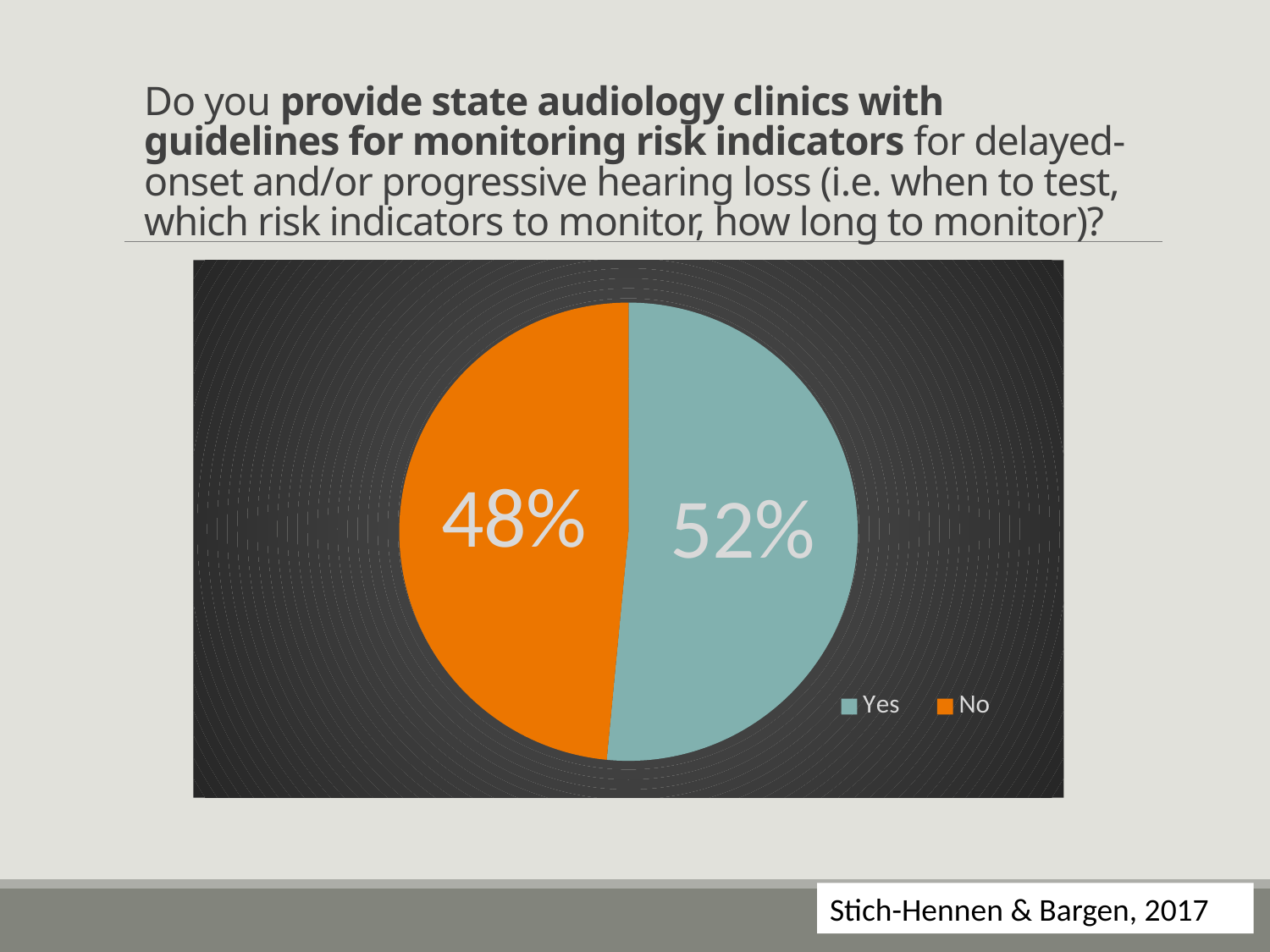
What kind of chart is shown on the slide? pie chart What percentage of respondents answered No? 48% Which response has the larger share of the pie? Yes What is the difference in percentage points between the Yes and No shares? 4 How many slices does the pie chart have? 2 What colour is the Yes slice? teal What colour is the No slice? orange How many entries does the legend list? 2 Is the share for Yes larger or smaller than the share for No? larger Which response has the smaller share of the pie? No What percentage of respondents answered Yes? 52% What share of the pie does the No slice represent? 48%